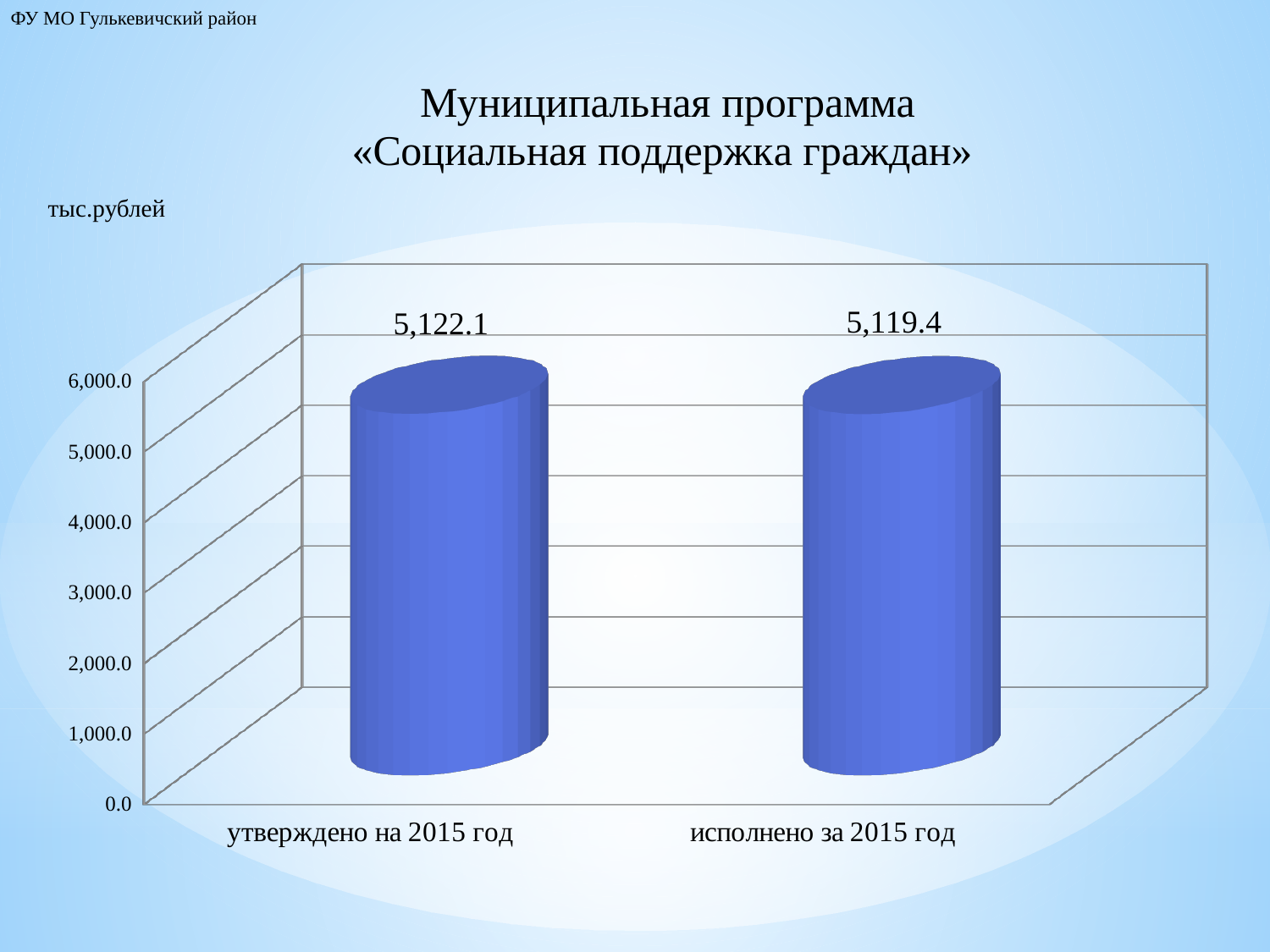
What is the value for «утверждено на 2015 год»? 5,122.1 Is the value for «исполнено за 2015 год» greater or less than 5,000.0? greater What unit of measurement is indicated for the chart values? тыс.рублей Which category has the higher value, «утверждено на 2015 год» or «исполнено за 2015 год»? утверждено на 2015 год Do the values rise or fall from «утверждено на 2015 год» to «исполнено за 2015 год»? fall What is the value for «исполнено за 2015 год»? 5,119.4 What kind of chart is shown on the slide? bar chart What is the title of the chart? Муниципальная программа «Социальная поддержка граждан» How many categories are shown on the chart? 2 Which category has the lowest value? исполнено за 2015 год What is the difference between the value for «утверждено на 2015 год» and the value for «исполнено за 2015 год»? 2.7 Is the value for «утверждено на 2015 год» greater or less than 6,000.0? less